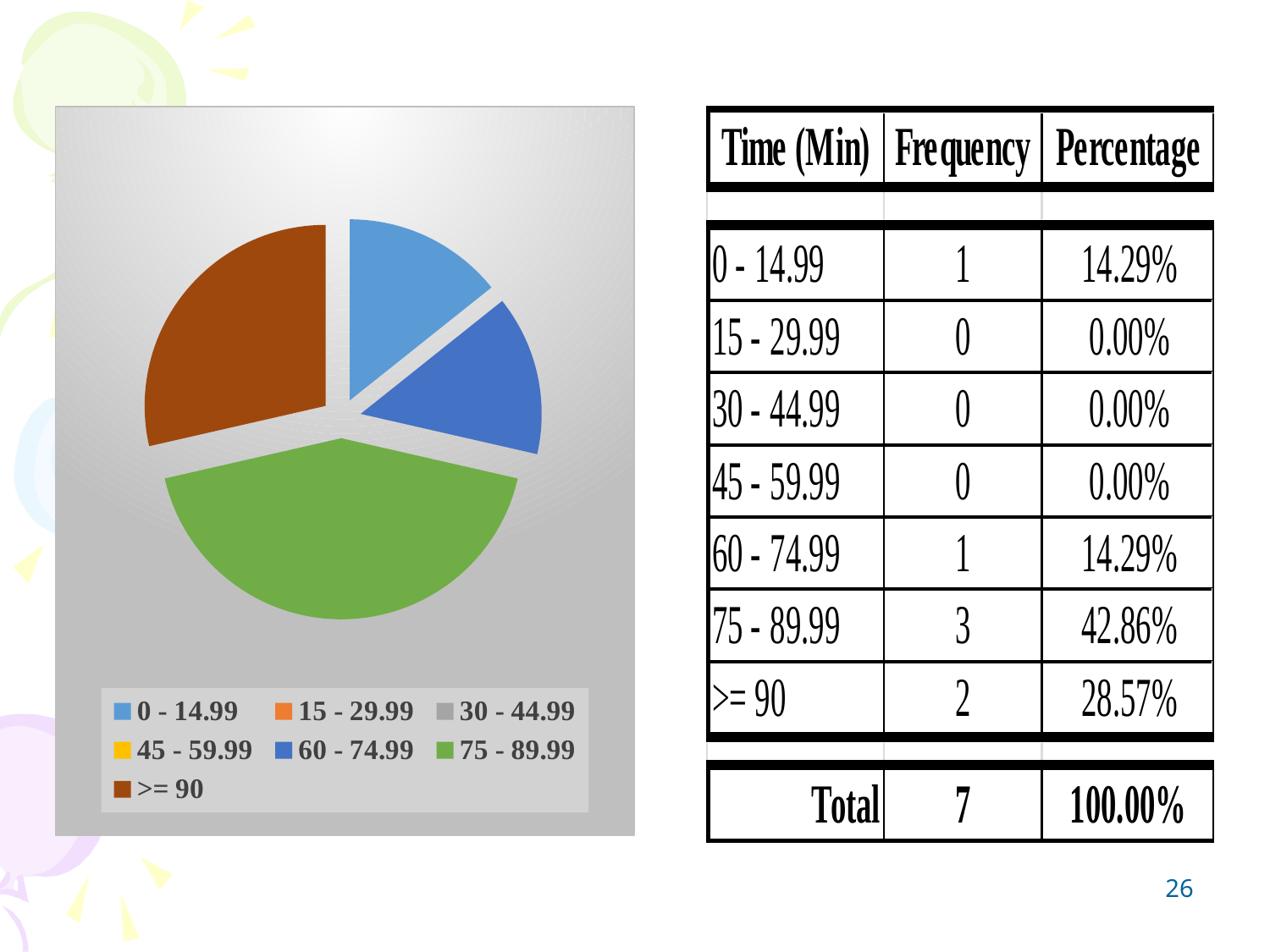
What is the frequency for the 75 - 89.99 category? 3 Which slice is larger in the pie chart, 75 - 89.99 or 60 - 74.99? 75 - 89.99 What share of the pie does the >= 90 category represent? 28.57% Which slice is larger in the pie chart, >= 90 or 0 - 14.99? >= 90 How many categories does the pie chart's legend list? 7 What kind of chart is shown on the left of the slide? pie chart What colour is the largest slice of the pie chart? green What colour does the legend use for the >= 90 category? brown What share of the pie does the 75 - 89.99 category represent? 42.86% How many slices are visible in the pie chart? 4 What is the total frequency across all categories? 7 Which category has the largest slice in the pie chart? 75 - 89.99